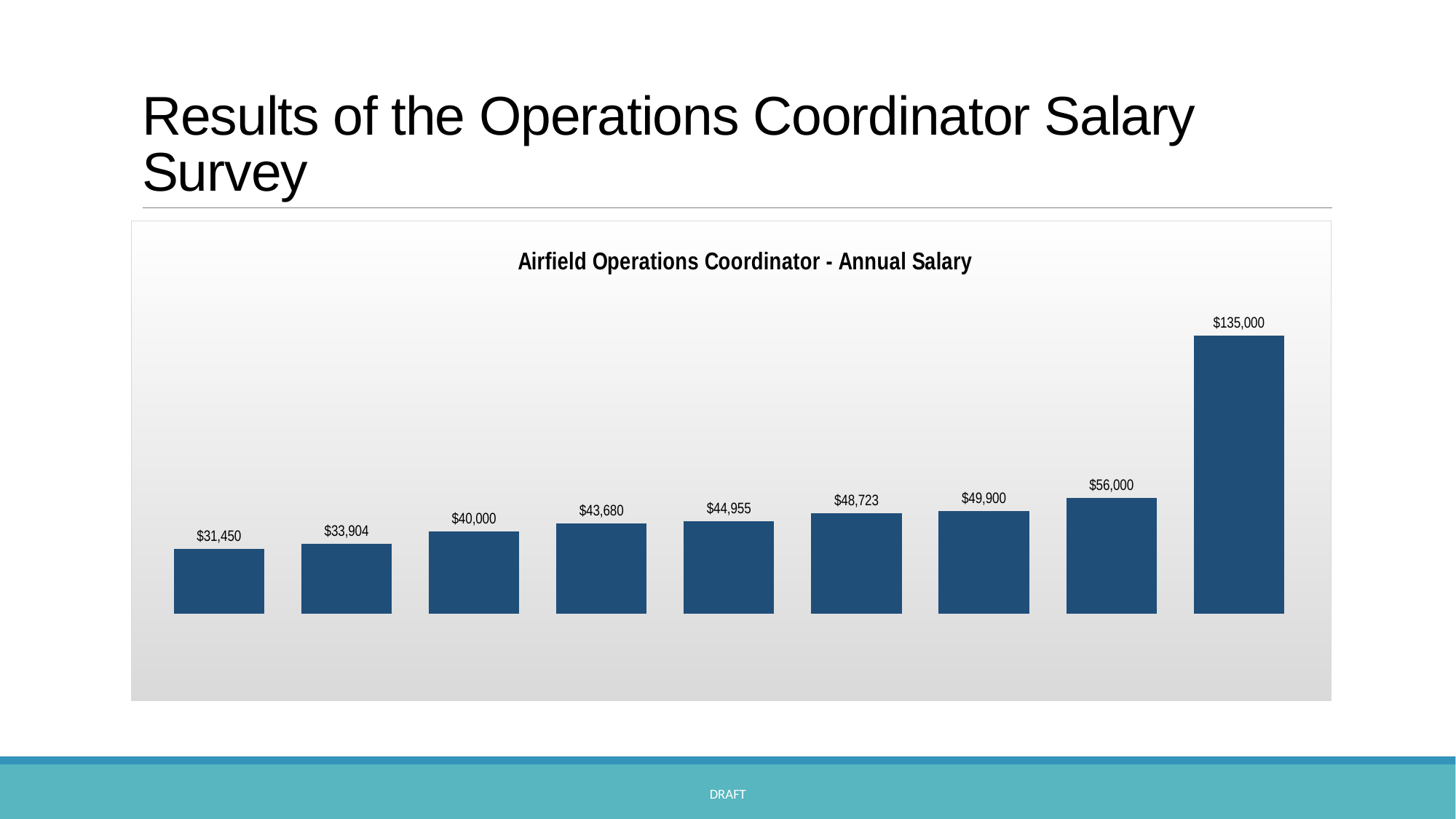
What kind of chart is shown on the slide? bar chart What is the highest salary value shown in the chart? $135,000 What is the title of the chart? Airfield Operations Coordinator - Annual Salary Do the bar values rise or fall from left to right across the chart? rise What is the lowest salary value shown in the chart? $31,450 What is the value shown on the rightmost bar? $135,000 What is the value shown on the leftmost bar? $31,450 Which is larger, the value of the fourth bar from the left or the value of the fifth bar from the left? the fifth bar ($44,955) How many bars are plotted in the chart? 9 What is the value shown on the third bar from the left? $40,000 What is the difference between the rightmost bar ($135,000) and the second bar from the right ($56,000)? $79,000 What is the value shown on the second bar from the right? $56,000